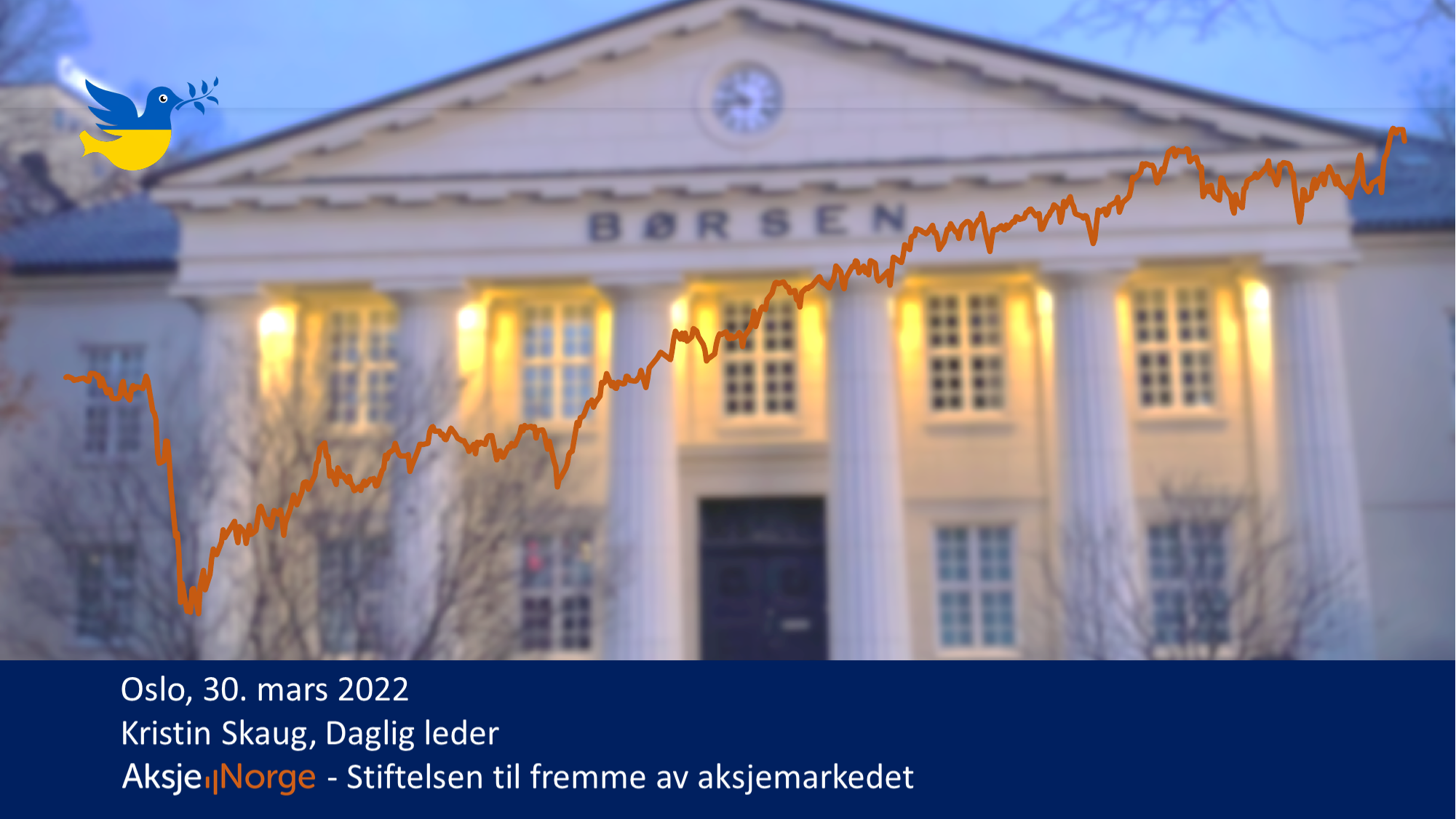
Is the highest point of the line near the left end or the right end of the chart? near the right end What kind of chart is overlaid on the photo of the stock exchange building? line chart Does the chart show any axes, axis labels or a legend? no What colour is the plotted line? orange Is the lowest point of the line near the left end or the right end of the chart? near the left end Overall, does the plotted line rise or fall from left to right? rise How many lines are plotted on the chart? 1 Does the line end higher or lower than where it starts on the left? higher